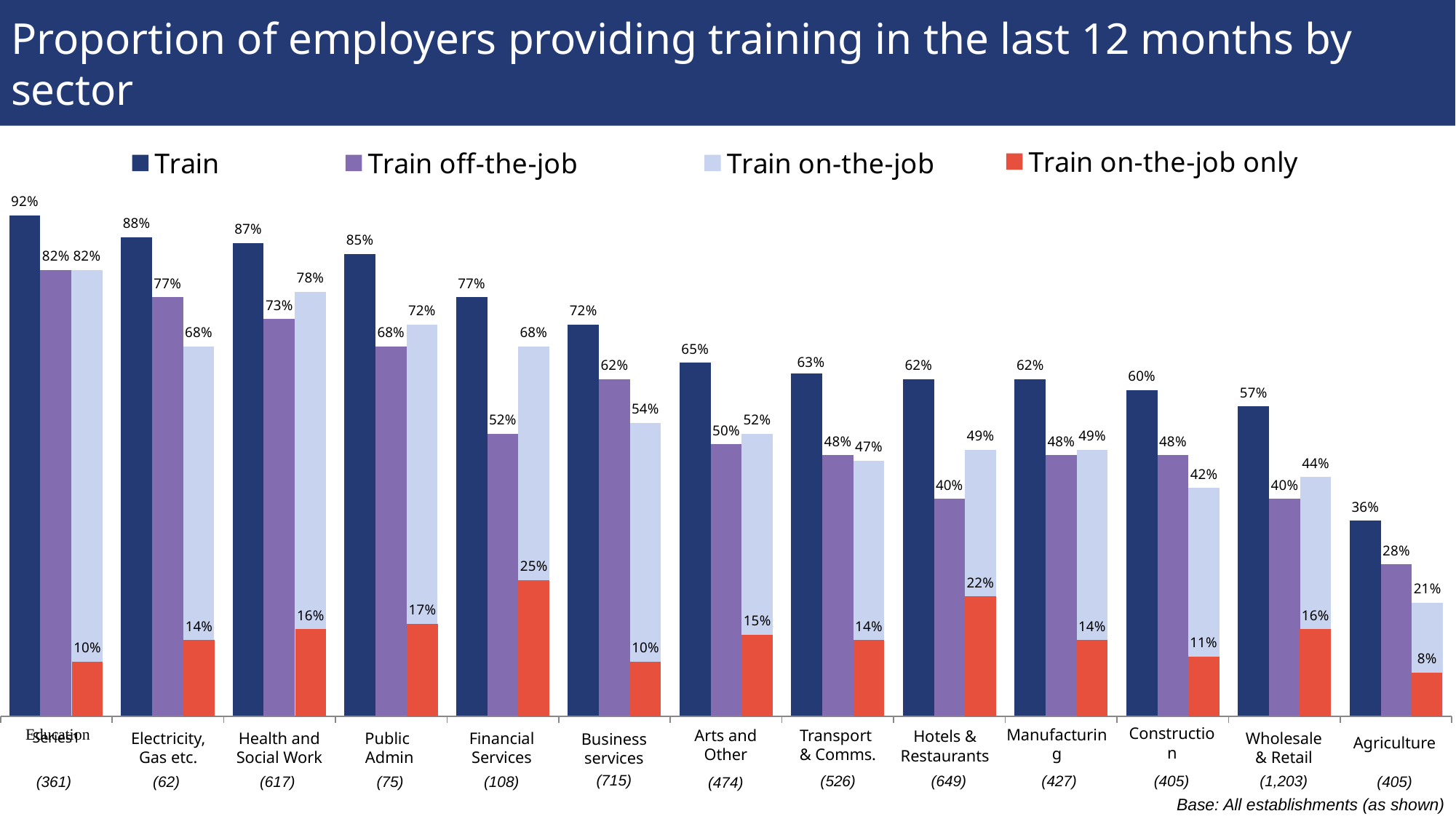
How many series does the legend list? 4 Which is larger: the 'Train on-the-job' value for Health and Social Work or the 'Train on-the-job' value for Business services? Health and Social Work Which sector has the lowest 'Train' value? Agriculture What is the 'Train off-the-job' value for Agriculture? 28% What is the 'Train on-the-job only' value for Hotels & Restaurants? 22% What is the difference between the 'Train' value for Public Admin and the 'Train' value for Wholesale & Retail? 28% Which sector has the highest 'Train on-the-job only' value? Financial Services What is the base (number of establishments) shown for Wholesale & Retail? 1,203 What type of chart is shown on the slide? Bar chart Do the 'Train' values rise or fall from left to right across the sectors? Fall What is the 'Train' value for Financial Services? 77% How many sectors are shown on the x axis? 13